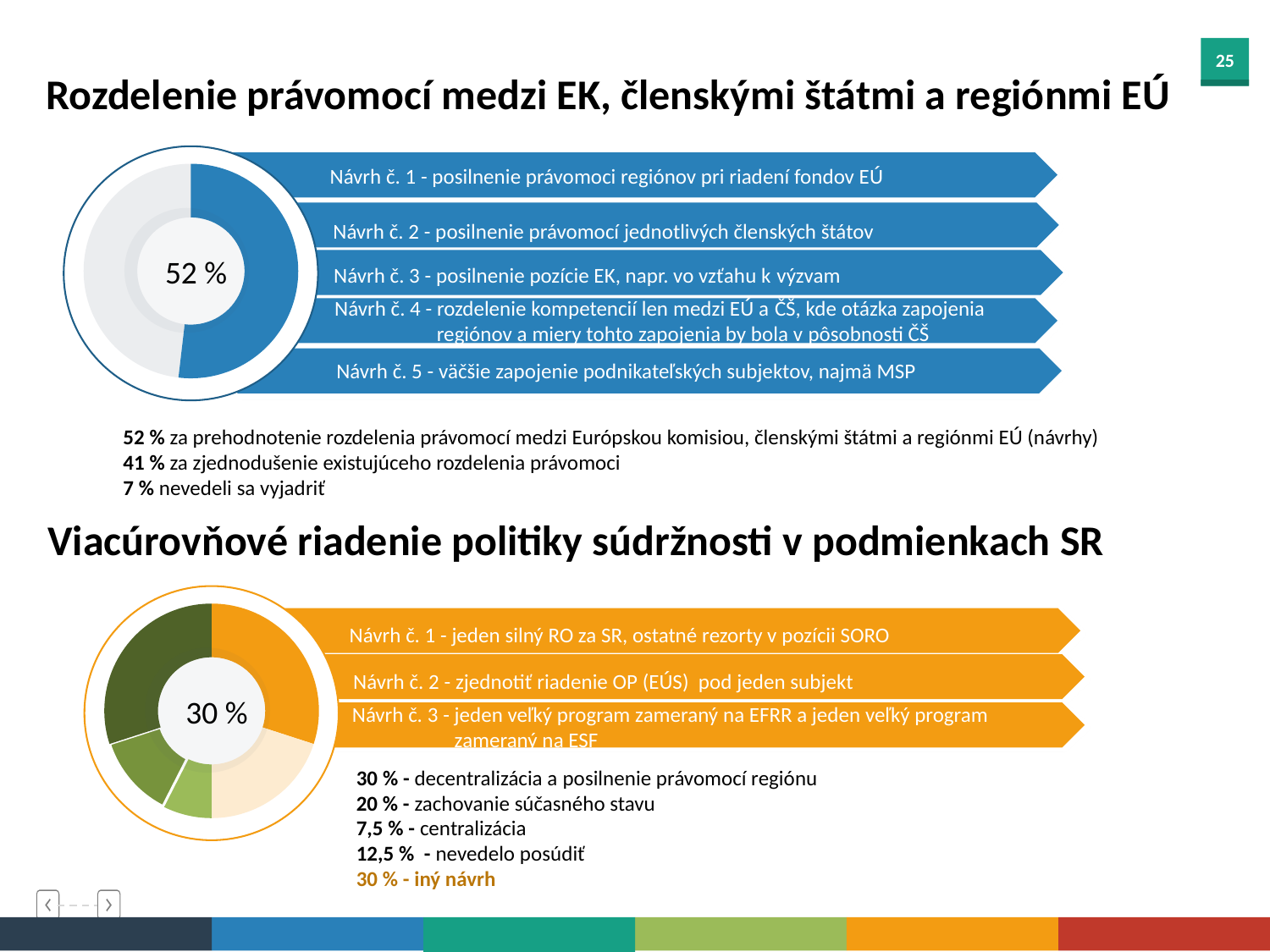
In the bottom chart (Viacúrovňové riadenie), which response has the smallest share? centralizácia In the top chart (Rozdelenie právomocí), what share is given for 'nevedeli sa vyjadriť'? 7 % In the top chart (Rozdelenie právomocí), which response has the smallest share? nevedeli sa vyjadriť In the bottom chart (Viacúrovňové riadenie), what share is given for 'centralizácia'? 7,5 % What kind of chart is shown next to the heading 'Rozdelenie právomocí medzi EK, členskými štátmi a regiónmi EÚ'? donut (pie) chart In the bottom chart (Viacúrovňové riadenie), which is larger: the share for 'decentralizácia a posilnenie právomocí regiónu' or the share for 'zachovanie súčasného stavu'? decentralizácia a posilnenie právomocí regiónu In the bottom chart (Viacúrovňové riadenie), what share is given for 'nevedelo posúdiť'? 12,5 % In the top chart (Rozdelenie právomocí), what value is printed in the centre of the donut? 52 % In the top chart (Rozdelenie právomocí), what share is given for 'za zjednodušenie existujúceho rozdelenia právomoci'? 41 % In the top chart (Rozdelenie právomocí), what is the difference between the share 'za prehodnotenie rozdelenia právomocí' and the share 'za zjednodušenie existujúceho rozdelenia právomoci'? 11 % How many response categories are listed for the bottom chart (Viacúrovňové riadenie)? 5 In the bottom chart (Viacúrovňové riadenie politiky súdržnosti v podmienkach SR), what value is printed in the centre of the donut? 30 %